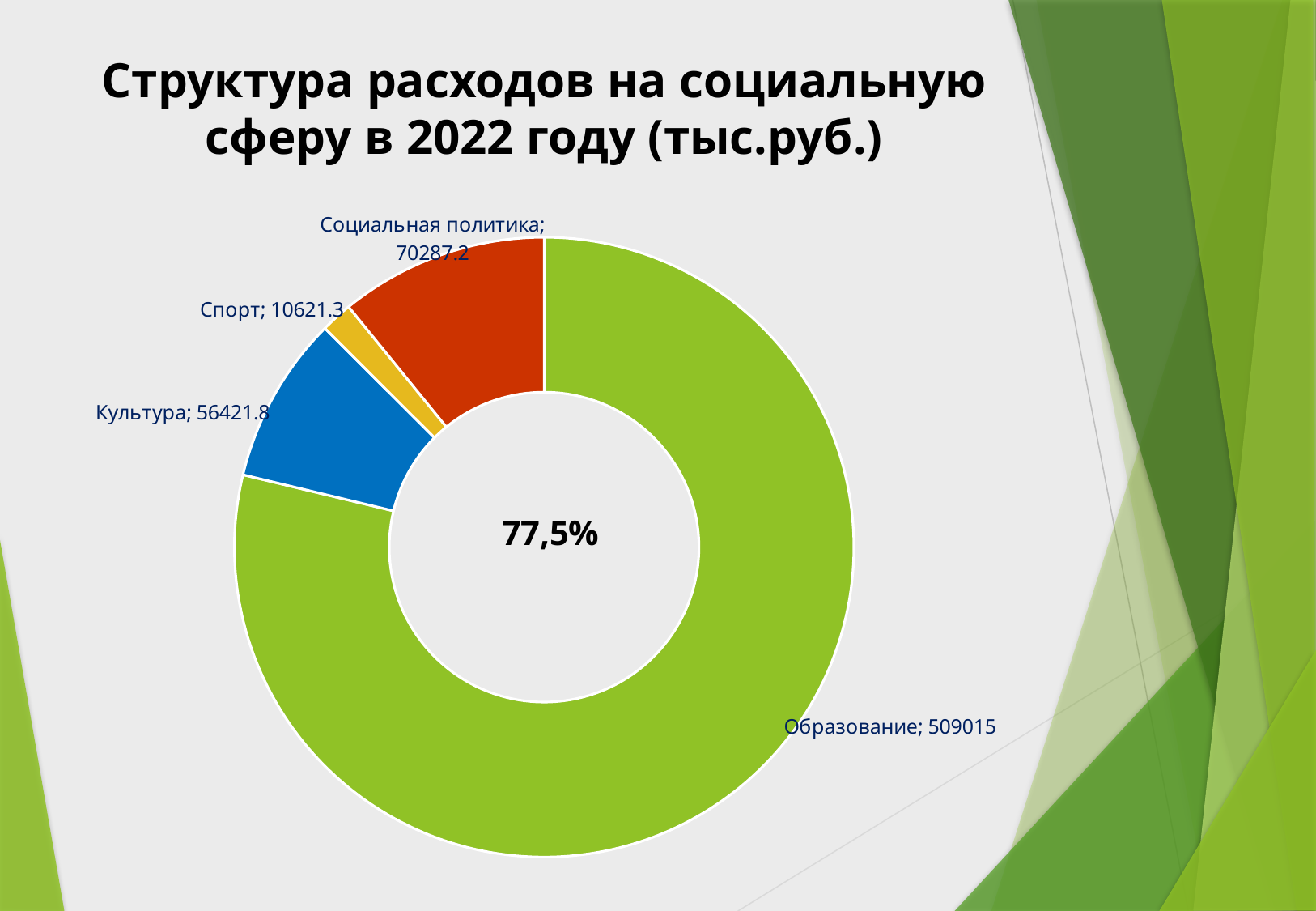
What is the difference between the values for Социальная политика and Культура? 13865.4 Which category has the largest value? Образование What is the difference between the values for Культура and Спорт? 45800.5 What kind of chart is shown on the slide? doughnut chart Which is larger, the value for Социальная политика or the value for Культура? Социальная политика What is the value for Образование? 509015 What is the value for Социальная политика? 70287.2 How many categories are shown in the chart? 4 Which category has the smallest value? Спорт What percentage is printed in the centre of the doughnut? 77,5% What is the value for Культура? 56421.8 What is the value for Спорт? 10621.3